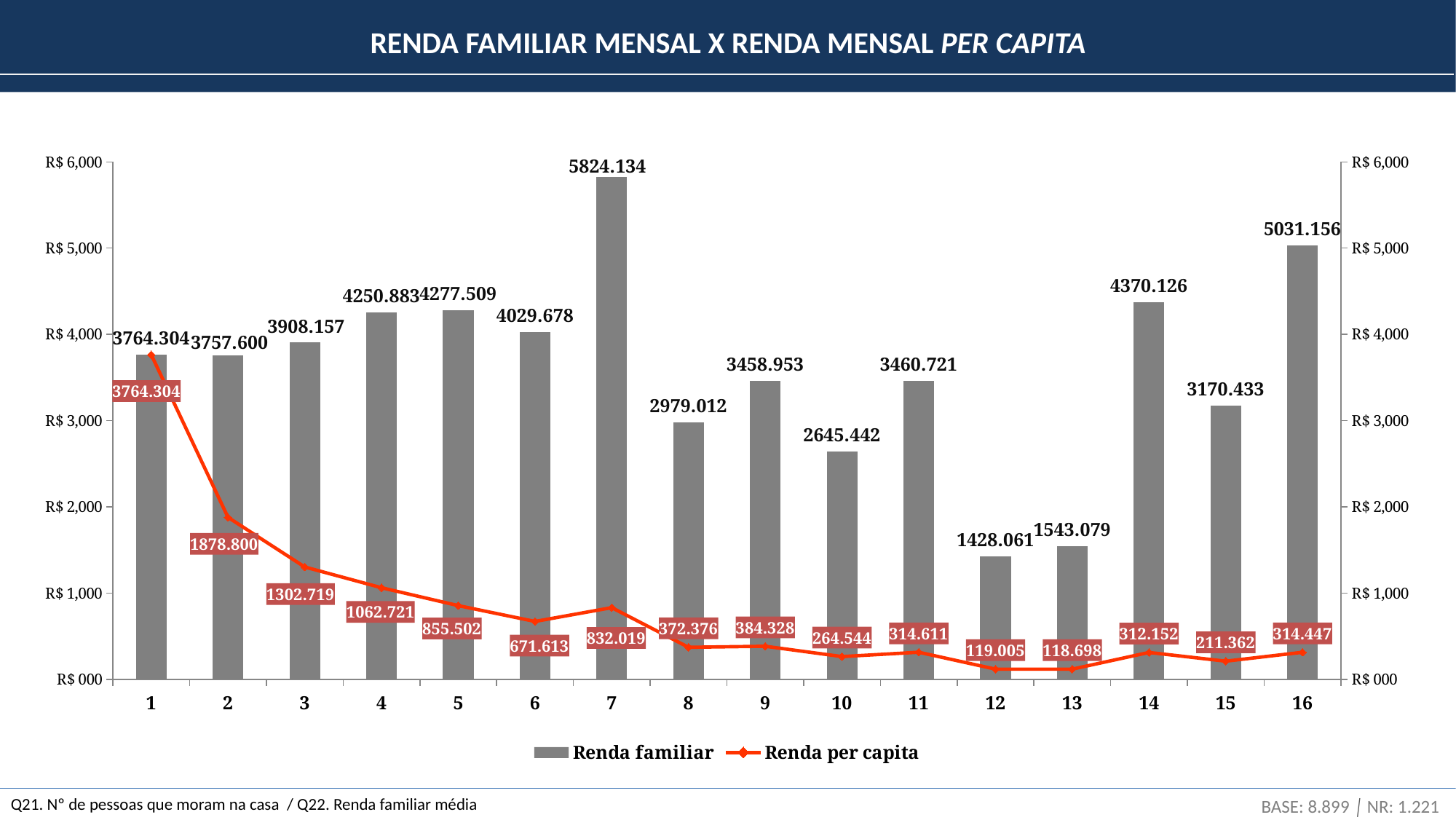
Which category has the lowest Renda familiar value? 12 What is the difference between the Renda per capita values for categories 2 and 3? 576.081 Which category has the highest Renda familiar value? 7 What is the difference between the Renda familiar values for categories 7 and 16? 792.978 Is the Renda familiar value for category 10 greater or less than R$ 3,000? less Does the Renda per capita line generally rise or fall from category 1 to category 16? fall Which is larger, the Renda familiar value for category 14 or for category 15? Category 14 What is the Renda per capita value for category 12? 119.005 How many categories are shown on the x axis? 16 How many series does the legend list? 2 Which category has the highest Renda per capita value? 1 What is the Renda familiar value for category 7? 5824.134